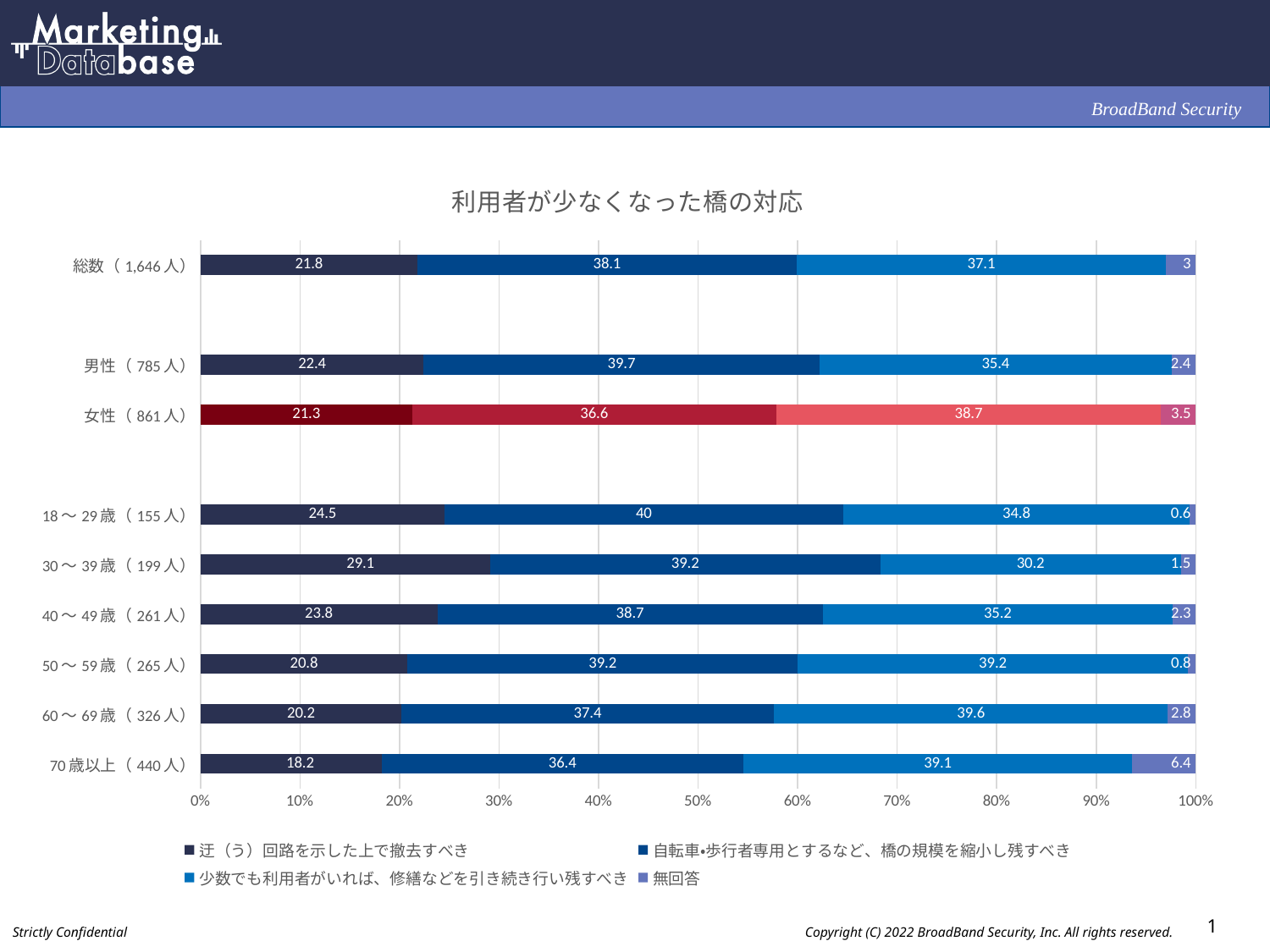
What is the value for 迂（う）回路を示した上で撤去すべき in the 総数（1,646人） category? 21.8 What is the value for 少数でも利用者がいれば、修繕などを引き続き行い残すべき in the 女性（861人） category? 38.7 Which category has the lowest value for 迂（う）回路を示した上で撤去すべき? 70歳以上（440人） Which category has the lowest value for 無回答? 18～29歳（155人） What kind of chart is shown on the slide? Stacked bar chart What is the difference between the 自転車•歩行者専用とするなど、橋の規模を縮小し残すべき values for 男性（785人） and 女性（861人）? 3.1 What is the title of the chart? 利用者が少なくなった橋の対応 How many categories are shown on the chart? 9 Which is larger: the 少数でも利用者がいれば、修繕などを引き続き行い残すべき value for 60～69歳（326人） or for 30～39歳（199人）? 60～69歳（326人） Which category has the highest value for 迂（う）回路を示した上で撤去すべき? 30～39歳（199人） What is the value for 無回答 in the 70歳以上（440人） category? 6.4 How many series does the legend list? 4